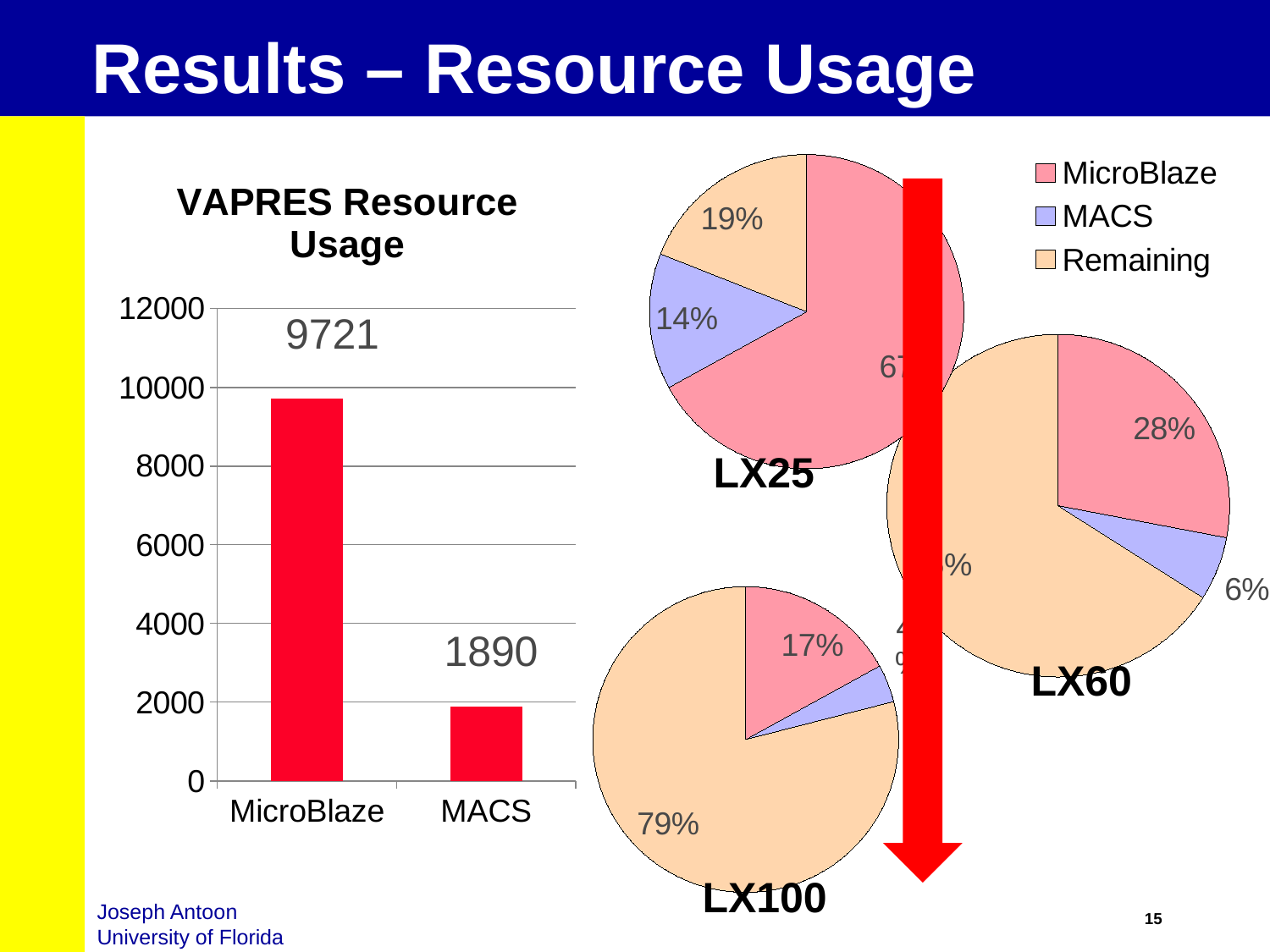
In the VAPRES Resource Usage bar chart, what is the value for MicroBlaze? 9721 In the VAPRES Resource Usage bar chart, which category has the higher value? MicroBlaze In the VAPRES Resource Usage bar chart, what is the value for MACS? 1890 In the LX25 pie chart, what share is MACS? 14% What kind of chart is the VAPRES Resource Usage chart? Bar chart In the VAPRES Resource Usage bar chart, what is the difference between the MicroBlaze and MACS values? 7831 In the LX60 pie chart, what share is MicroBlaze? 28% In the VAPRES Resource Usage bar chart, is the value for MACS greater or less than 2000? less How many entries does the legend for the pie charts list? 3 In the LX25 pie chart, what share is labelled Remaining? 19%